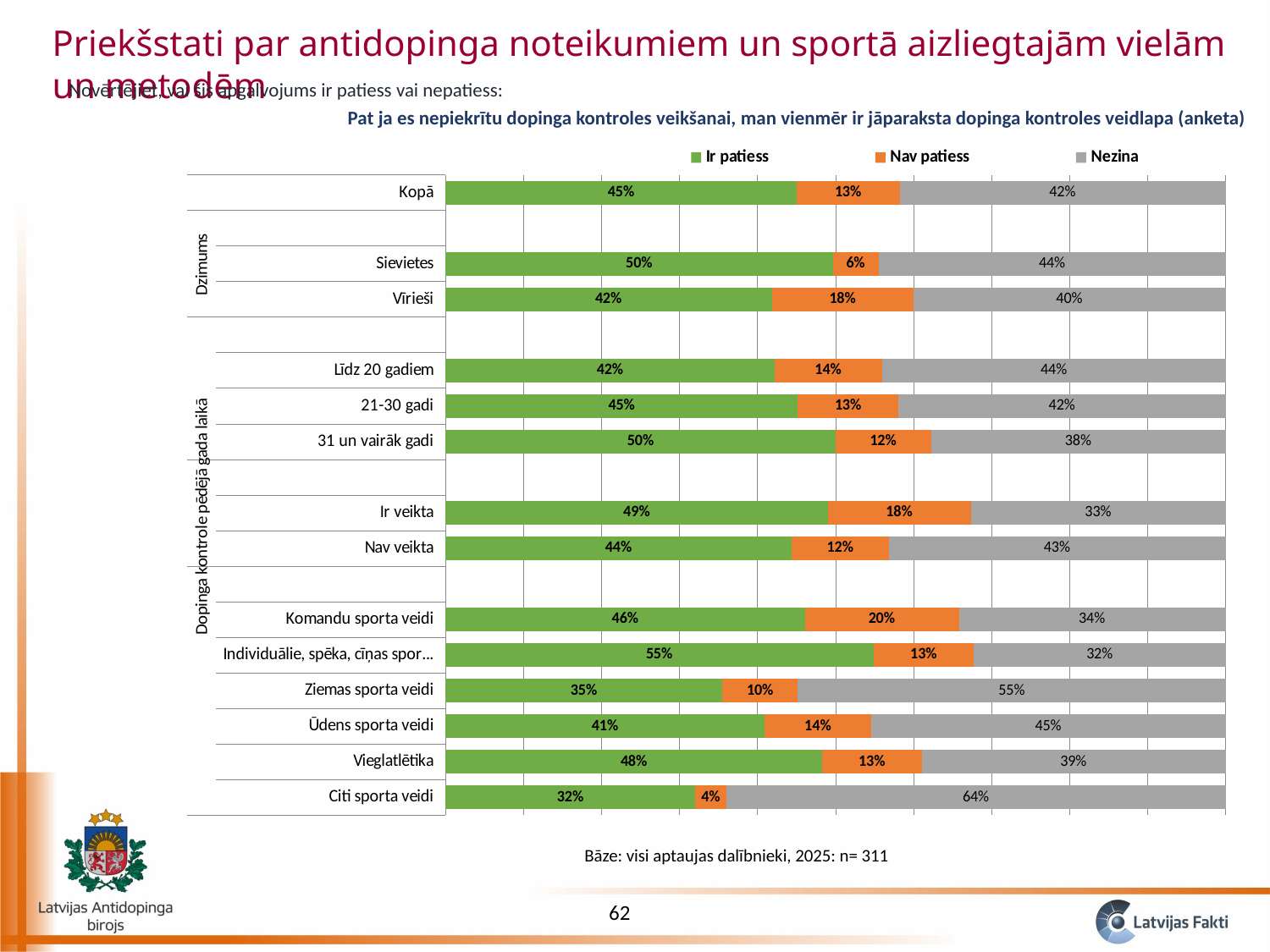
What kind of chart is shown on the slide? Stacked bar chart What is the difference between the "Ir patiess" values for "Sievietes" and "Vīrieši"? 8% How many series does the legend list? 3 Which has a larger "Nezina" value, "Ziemas sporta veidi" or "Ūdens sporta veidi"? Ziemas sporta veidi Which category has the lowest "Nav patiess" value? Citi sporta veidi What is the "Nav patiess" value for "Vīrieši"? 18% Which colour represents the "Nezina" series in the chart? Grey What percentage of respondents in the "Kopā" row answered "Ir patiess"? 45% What is the total of the "Ir patiess" and "Nav patiess" values for "Komandu sporta veidi"? 66% Which category has the highest "Ir patiess" value? Individuālie, spēka, cīņas spor... What is the "Nezina" value for "Citi sporta veidi"? 64% How many categories (rows) are plotted in the chart? 14